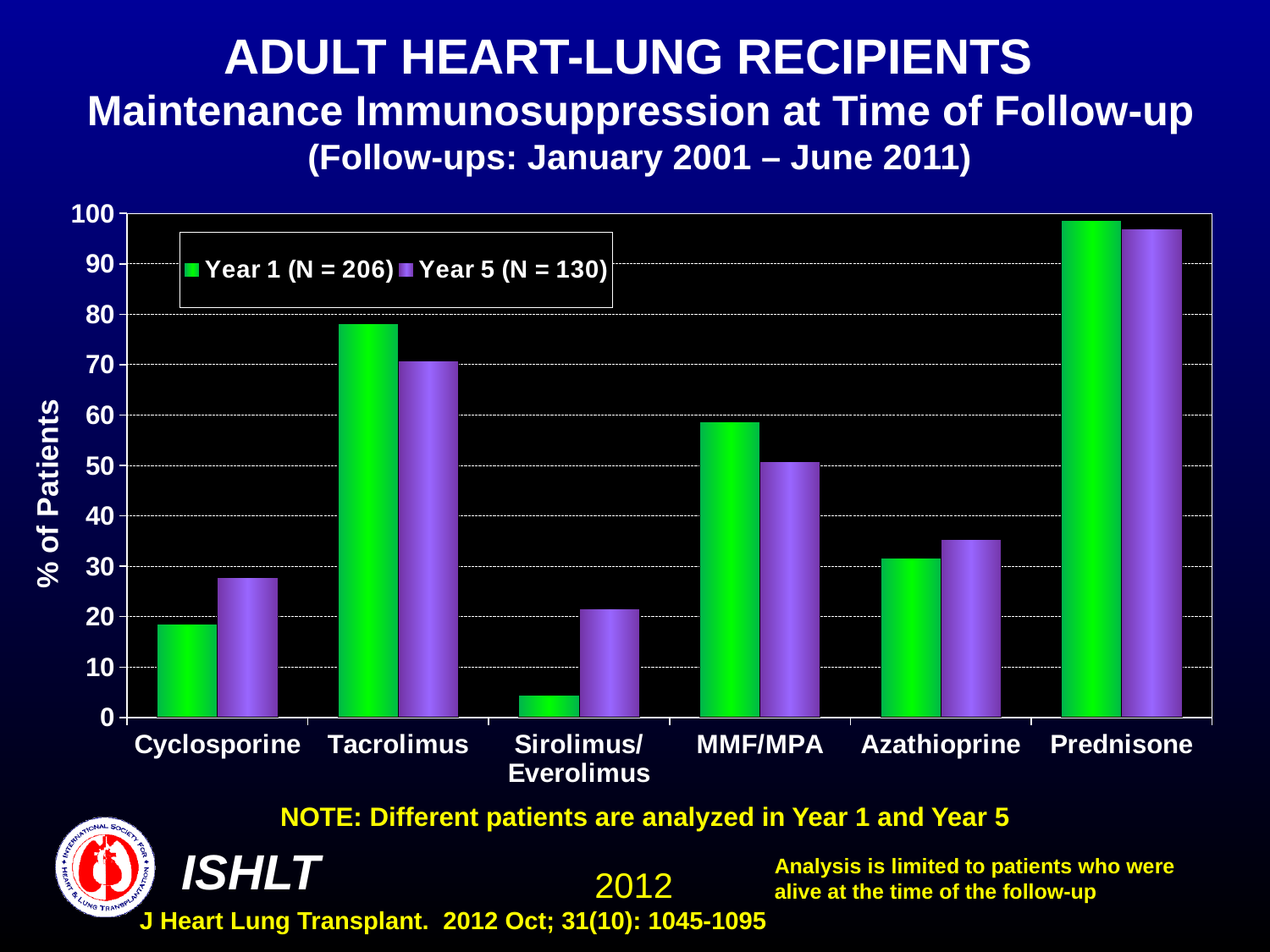
Is the Year 1 value for Tacrolimus greater or less than 70? greater Is the Year 5 value for Azathioprine greater or less than 30? greater For Cyclosporine, which is larger: the Year 1 value or the Year 5 value? Year 5 What kind of chart is shown on the slide? bar chart Which drug has the lowest Year 1 percentage of patients? Sirolimus/Everolimus Is the Year 1 value for Sirolimus/Everolimus greater or less than 10? less Which drug has the highest Year 1 percentage of patients? Prednisone For Tacrolimus, which is larger: the Year 1 value or the Year 5 value? Year 1 According to the legend, what is N for the Year 1 series? 206 How many drug categories are shown on the x axis? 6 How many series does the legend list? 2